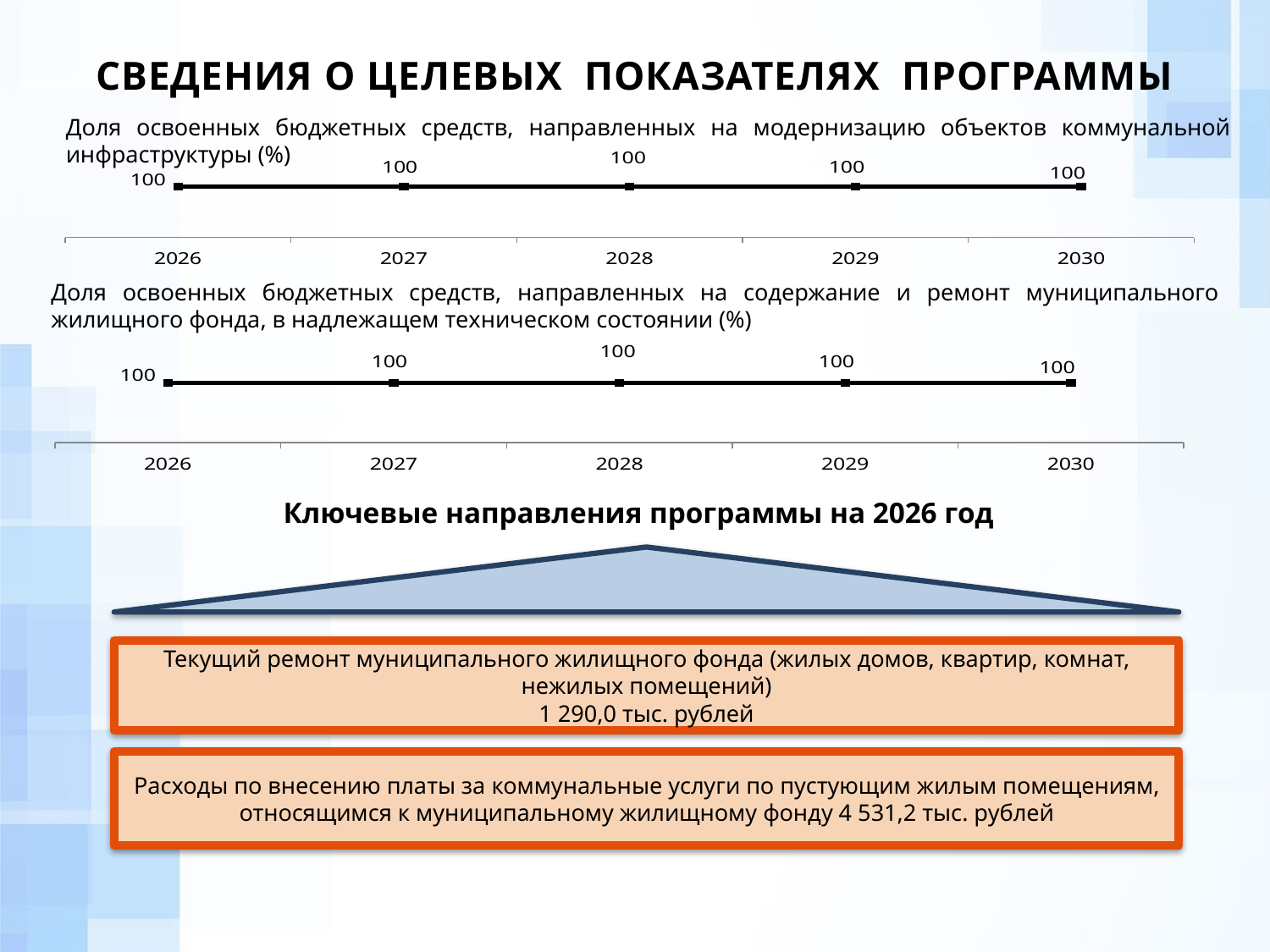
In the top chart (share of budget funds for modernisation of communal infrastructure), what is the value for 2026? 100 In the top chart (share of budget funds for modernisation of communal infrastructure), what is the value for 2030? 100 What is the first year shown on the x axis of the bottom chart? 2026 In the top chart, do the values rise, fall or stay flat from 2026 to 2030? stay flat What kind of chart is the top chart? line chart In the bottom chart, do the values rise, fall or stay flat from 2026 to 2030? stay flat How many years are plotted in the top chart? 5 In the bottom chart (share of budget funds for maintenance and repair of municipal housing stock), what is the value for 2028? 100 How many data points does the bottom chart show? 5 In the top chart, what is the difference between the values for 2027 and 2029? 0 What kind of chart is the bottom chart? line chart In the bottom chart (share of budget funds for maintenance and repair of municipal housing stock), what is the value for 2029? 100